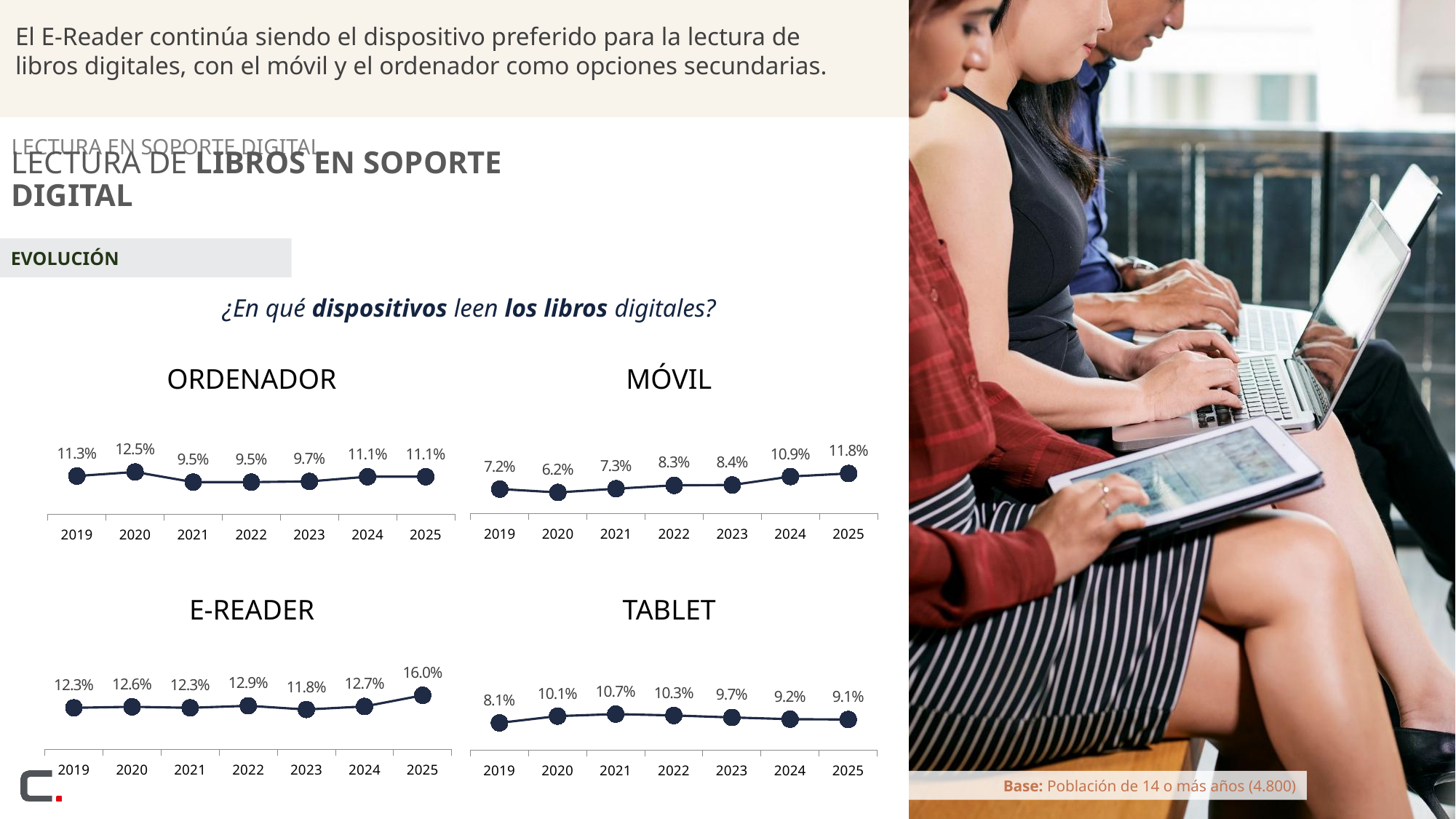
In the MÓVIL chart, what is the value for 2025? 11.8% What kind of chart is the MÓVIL chart? line chart In the E-READER chart, what is the difference between the 2025 value and the 2024 value? 3.3% In the TABLET chart, do the values rise or fall from 2021 to 2025? fall What question is posed above the four charts? ¿En qué dispositivos leen los libros digitales? In the MÓVIL chart, do the values generally rise or fall from 2020 to 2025? rise In the ORDENADOR chart, what is the value for 2020? 12.5% In the MÓVIL chart, which year has the lowest value? 2020 How many data points does the ORDENADOR chart show? 7 In the TABLET chart, which year has the highest value? 2021 In the TABLET chart, which is larger, the value for 2019 or the value for 2020? 2020 In the E-READER chart, what is the value for 2023? 11.8%